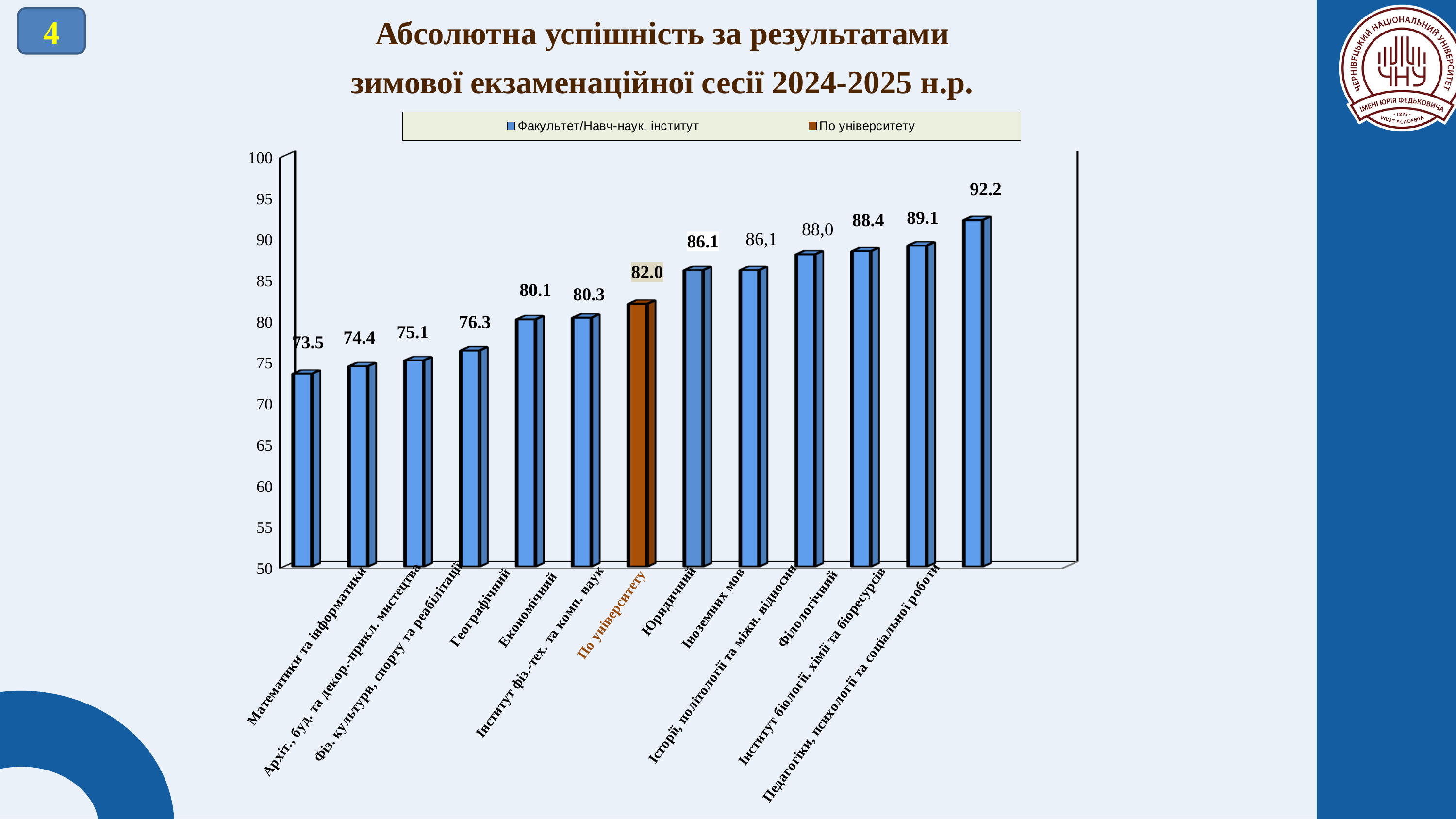
Which category has the highest value? Педагогіки, психології та соціальної роботи What type of chart is shown on the slide? bar chart How many bars are plotted in the chart? 13 What is the value for Філологічний? 88.4 How many series does the legend list? 2 What is the value for Педагогіки, психології та соціальної роботи? 92.2 What is the difference between the values for Інститут біології, хімії та біоресурсів and Географічний? 12.8 What is the value shown for По університету? 82.0 Which bar is shown in orange rather than blue? По університету What is the value for Математики та інформатики? 73.5 Which category has the lowest value? Математики та інформатики Which is larger, the value for Економічний or the value for Юридичний? Юридичний